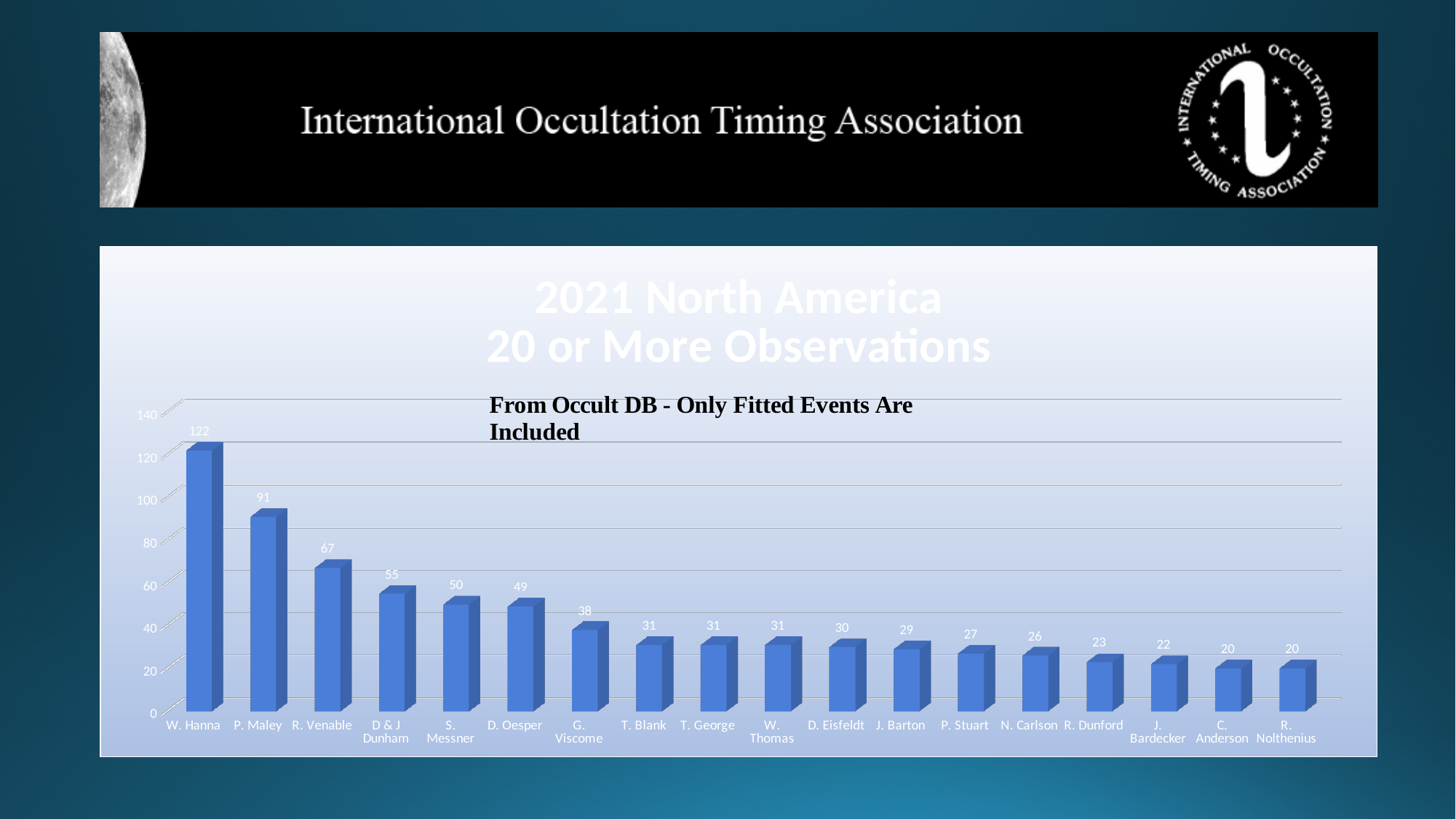
What is the title of the chart? 2021 North America 20 or More Observations Which observer has the highest number of observations? W. Hanna Which is larger, the value for G. Viscome or the value for T. Blank? G. Viscome What is the value for D. Oesper? 49 What is the value for W. Hanna? 122 Do the values rise or fall from left to right along the x axis? fall Is the value for P. Maley greater or less than 80? greater What is the difference between the values for W. Hanna and P. Maley? 31 How many observers are shown on the chart? 18 What is the difference between the values for R. Venable and D & J Dunham? 12 What is the value for R. Dunford? 23 What kind of chart is shown on the slide? bar chart